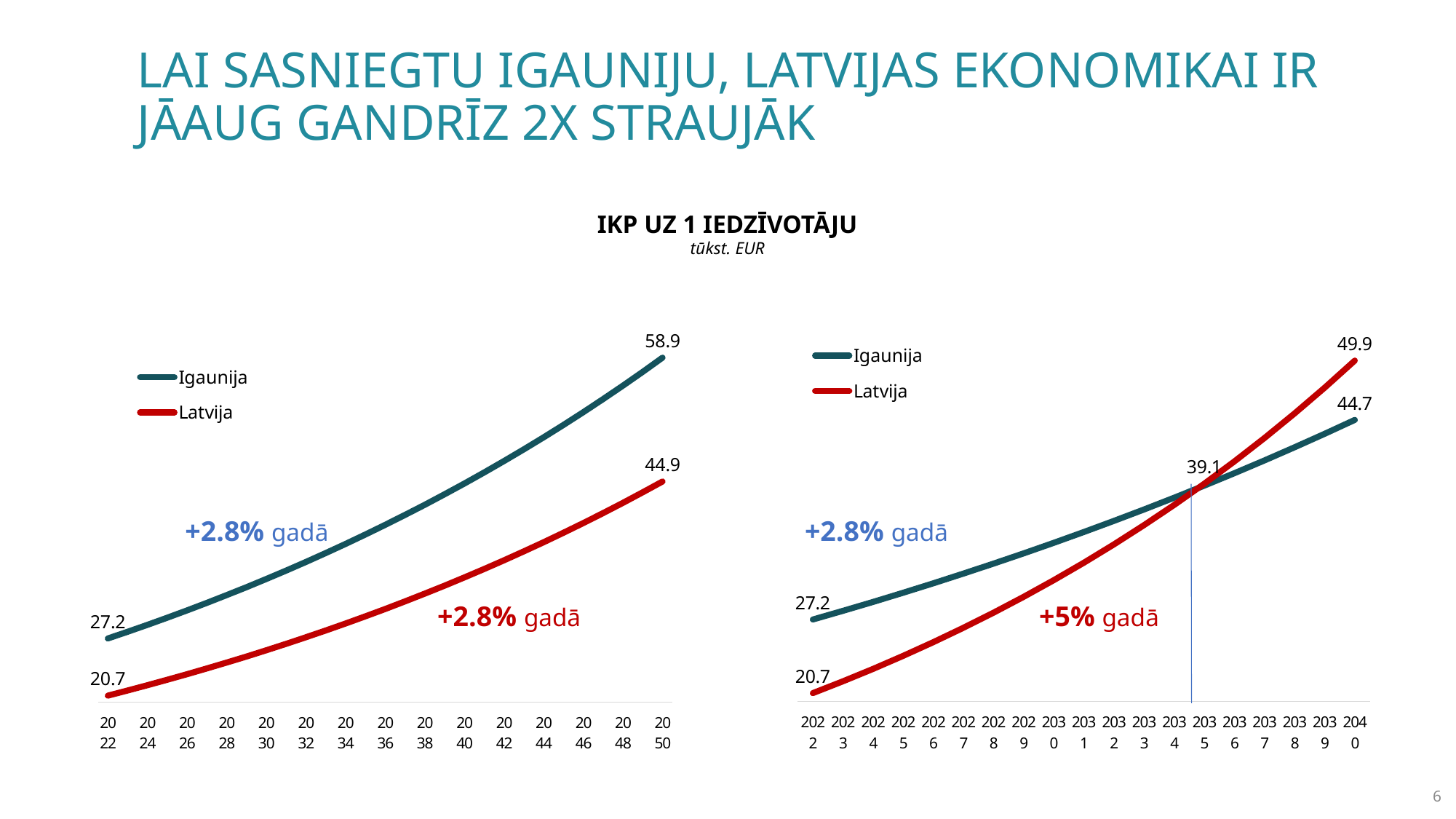
How many series does the legend of the right chart list? 2 In the left chart, what is the starting value for Latvija in 2022? 20.7 In the right chart, which series has the higher value in 2040, Igaunija or Latvija? Latvija What kind of chart is the left chart? Line chart In the left chart, which series has the higher value in 2050? Igaunija In the left chart, what is the value for Latvija in 2050? 44.9 In the right chart, does the Latvija line rise or fall from 2022 to 2040? Rise In the left chart, what is the difference between Igaunija and Latvija in 2050? 14.0 In the right chart, what is the value for Igaunija in 2040? 44.7 In the left chart, what is the value for Igaunija in 2050? 58.9 What annual growth rate is annotated for Latvija in the right chart? +5% gadā In the right chart, what is the value for Latvija in 2040? 49.9